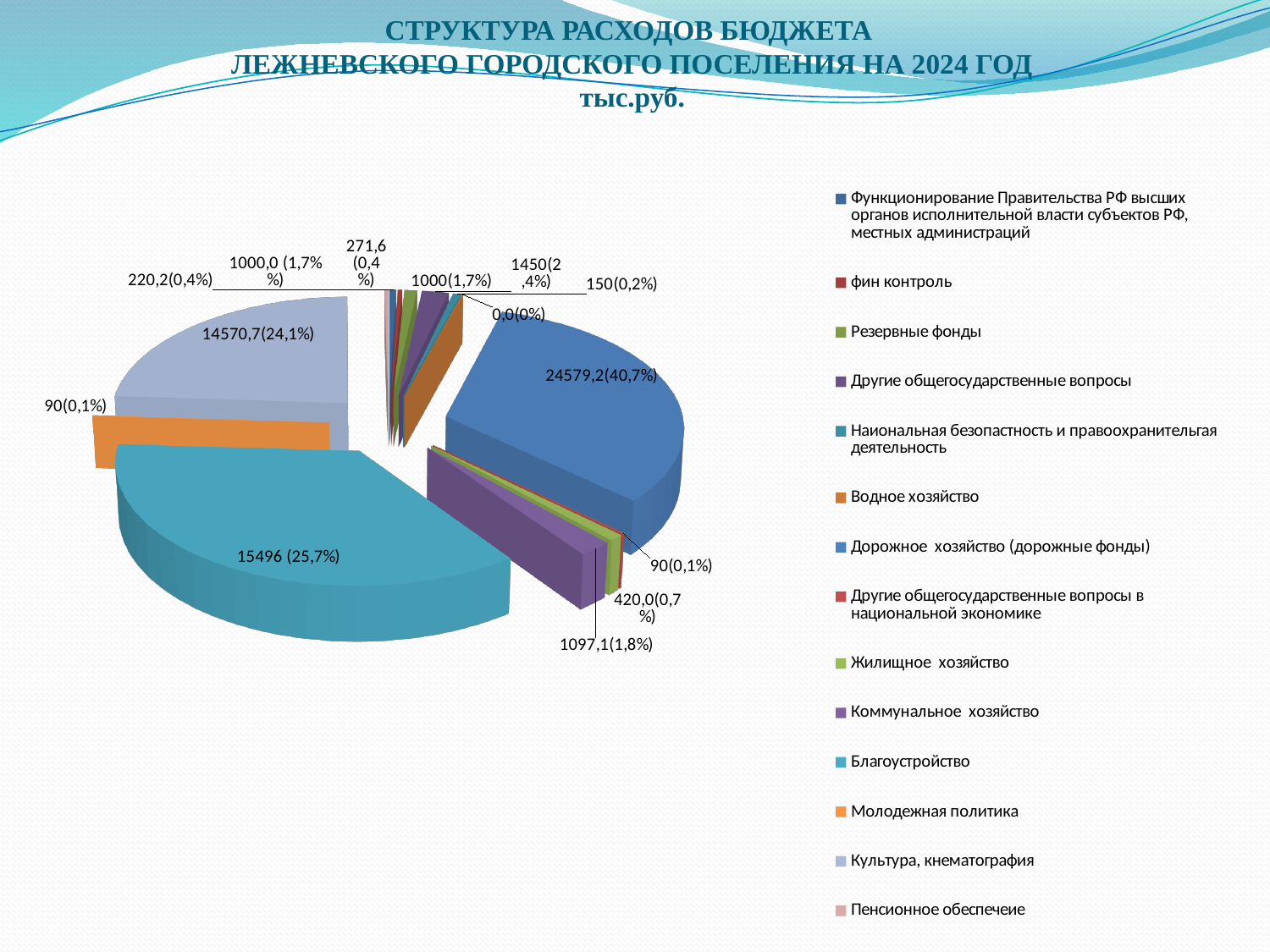
What share of the pie does the slice labelled 15496 represent? 25,7% How many entries does the legend of the pie chart list? 14 What share of the pie does the slice labelled 14570,7 represent? 24,1% What is the difference between the slice labelled 1450 and the slice labelled 1000? 450 What kind of chart is shown on the slide? pie chart Which legend entry corresponds to the teal slice labelled 15496 (25,7%)? Благоустройство What is the value of the largest slice of the pie chart? 24579,2 What share of the pie does the largest slice (24579,2) represent? 40,7% Which is larger: the slice labelled 1097,1 or the slice labelled 420,0? 1097,1 For which year does the chart show the budget expenditure structure? 2024 Which legend entry corresponds to the largest slice of the pie chart (40,7%)? Дорожное хозяйство (дорожные фонды) What unit of measurement is stated in the chart title? тыс.руб.